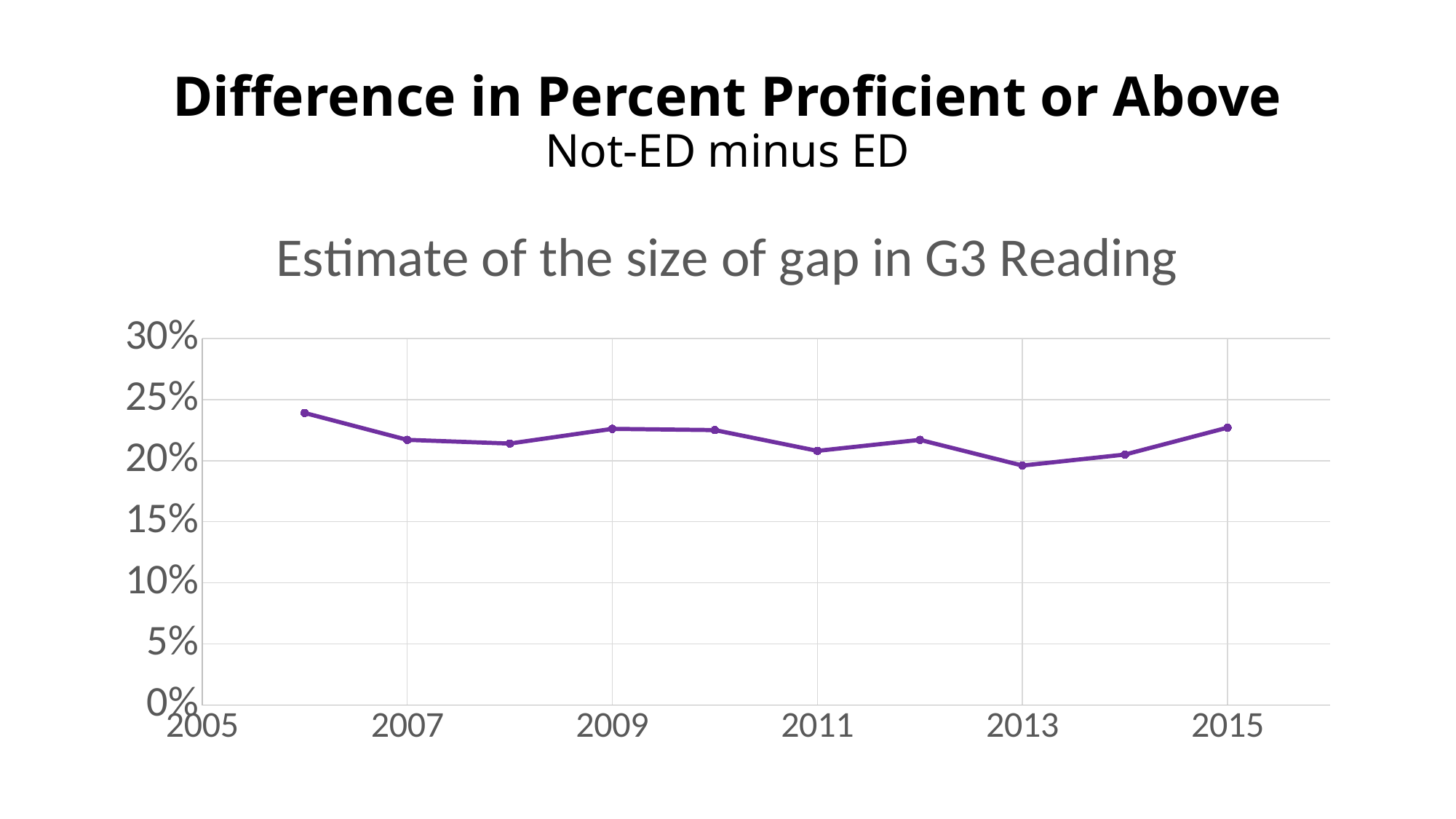
How many data points are plotted on the line? 10 Which is larger, the value for 2006 or the value for 2013? 2006 What is the title of the chart? Estimate of the size of gap in G3 Reading Is the value for 2006 greater or less than 25%? less Which year has the highest value on the chart? 2006 Is the value for 2015 greater or less than 25%? less Which is larger, the value for 2009 or the value for 2011? 2009 Do the values rise or fall from 2013 to 2015? rise What kind of chart is shown on the slide? line chart Which year has the lowest value on the chart? 2013 Is the value for 2011 greater or less than 20%? greater